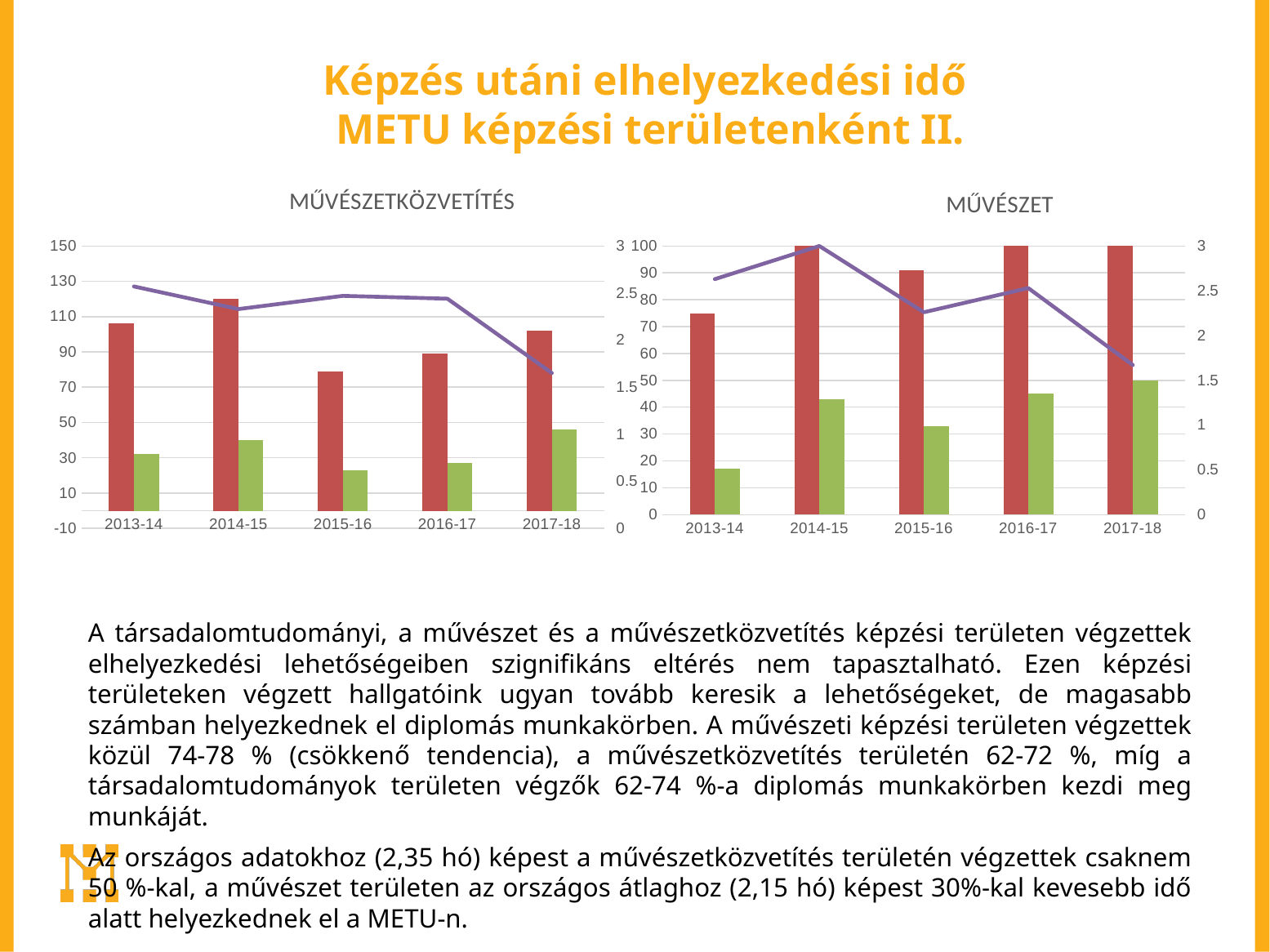
How many academic-year categories are shown on the x axis of the MŰVÉSZET chart? 5 In the MŰVÉSZET chart, which green bar is taller: 2014-15 or 2015-16? 2014-15 What kind of chart is the MŰVÉSZETKÖZVETÍTÉS chart on the left? A combined bar and line chart In the MŰVÉSZET chart, which year has the shortest red bar? 2013-14 In the MŰVÉSZETKÖZVETÍTÉS chart, which year has the shortest red bar? 2015-16 In the MŰVÉSZETKÖZVETÍTÉS chart, which year has the tallest red bar? 2014-15 In the MŰVÉSZETKÖZVETÍTÉS chart, is the green bar for 2017-18 greater or less than 50? less In the MŰVÉSZET chart, which year has the tallest green bar? 2017-18 In the MŰVÉSZET chart, does the purple line rise or fall from 2016-17 to 2017-18? Fall In the MŰVÉSZET chart, is the green bar for 2013-14 greater or less than 20? less In the MŰVÉSZETKÖZVETÍTÉS chart, is the red bar for 2013-14 greater or less than 90? greater